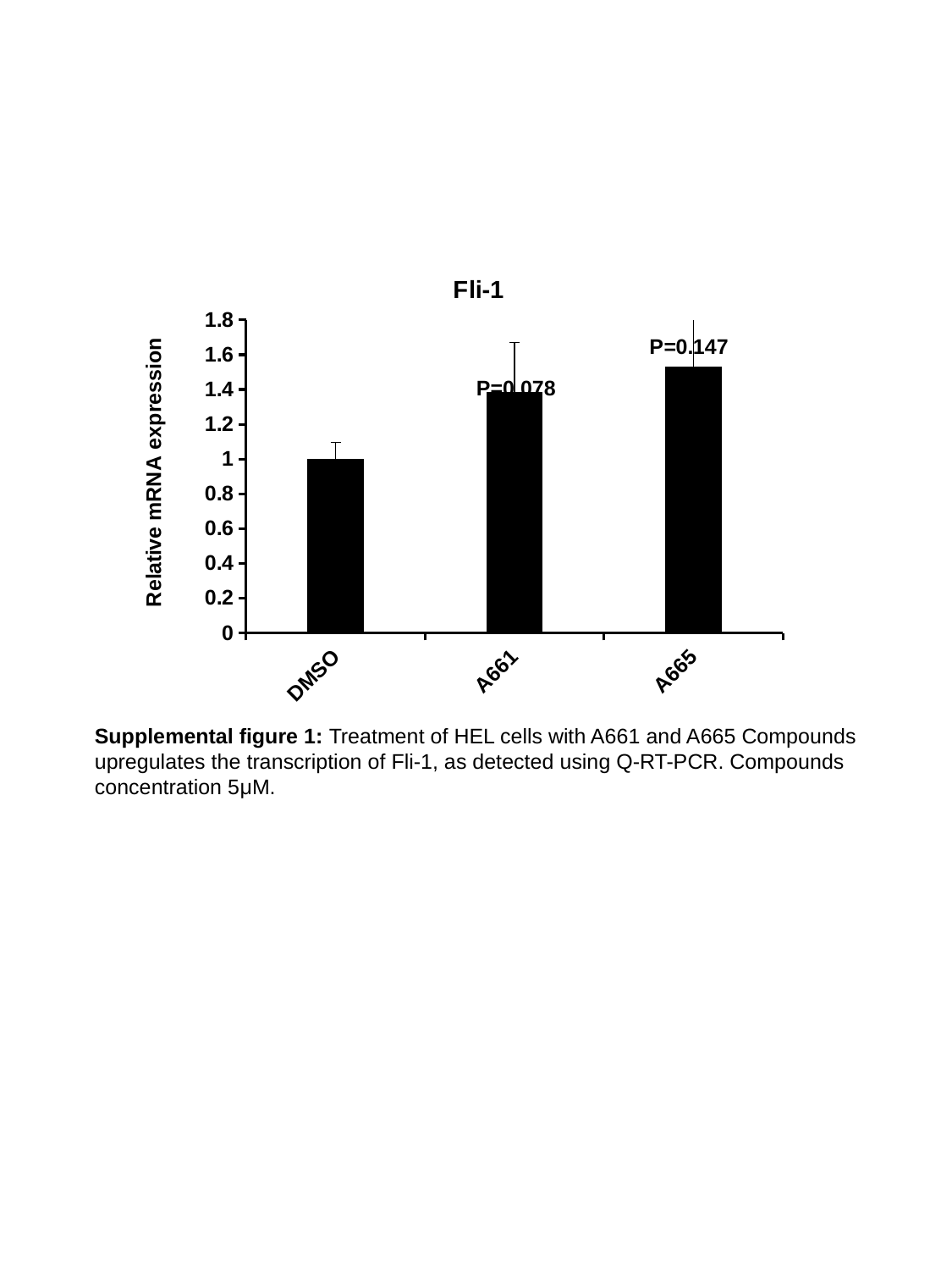
Which category has the lowest relative mRNA expression? DMSO Which category has the highest relative mRNA expression? A665 What is the title of the chart? Fli-1 What P value is printed above the A661 bar? P=0.078 What is the label of the y axis? Relative mRNA expression What is the relative mRNA expression value for DMSO? 1 What kind of chart is shown on the slide? bar chart Is the value for A661 greater or less than 1.6? less Is the value for A661 greater or less than 1.2? greater How many categories are plotted on the x axis? 3 Is the value for A665 greater or less than 1.4? greater Which has a larger relative mRNA expression, A661 or A665? A665